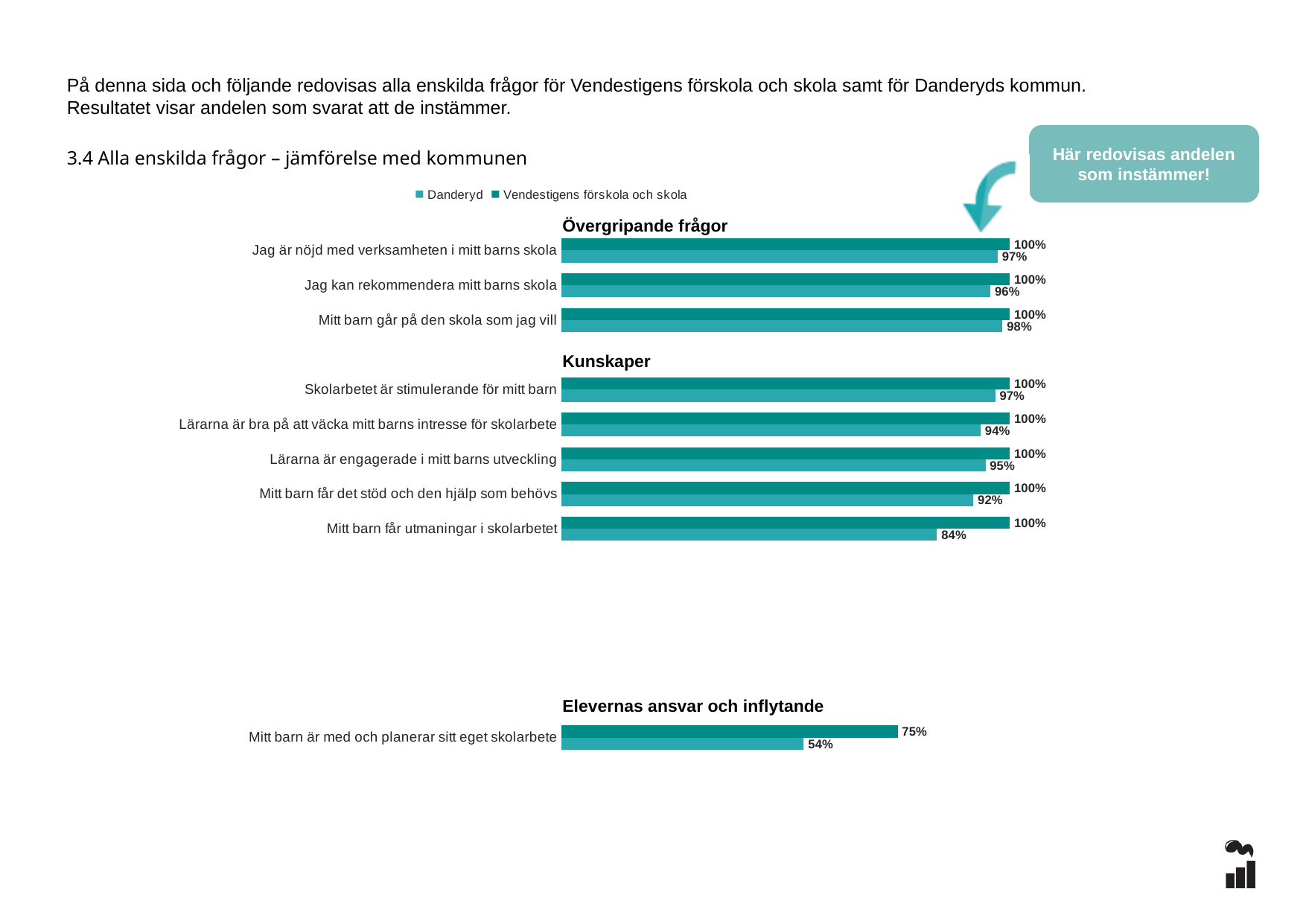
What is the difference between Vendestigens förskola och skola and Danderyd for 'Mitt barn är med och planerar sitt eget skolarbete'? 21% How many questions are listed under the 'Kunskaper' section? 5 What is the value for Vendestigens förskola och skola for 'Mitt barn är med och planerar sitt eget skolarbete'? 75% What is the value for Danderyd for 'Jag kan rekommendera mitt barns skola'? 96% What is the value for Danderyd for 'Mitt barn är med och planerar sitt eget skolarbete'? 54% What kind of chart is shown on the slide? bar chart Which question has the lowest value for Danderyd? Mitt barn är med och planerar sitt eget skolarbete What is the value for Vendestigens förskola och skola for 'Jag är nöjd med verksamheten i mitt barns skola'? 100% How many series does the legend list? 2 What is the value for Danderyd for 'Mitt barn får utmaningar i skolarbetet'? 84% What is the difference between Vendestigens förskola och skola and Danderyd for 'Mitt barn får det stöd och den hjälp som behövs'? 8% Which is larger for 'Lärarna är bra på att väcka mitt barns intresse för skolarbete': Danderyd or Vendestigens förskola och skola? Vendestigens förskola och skola